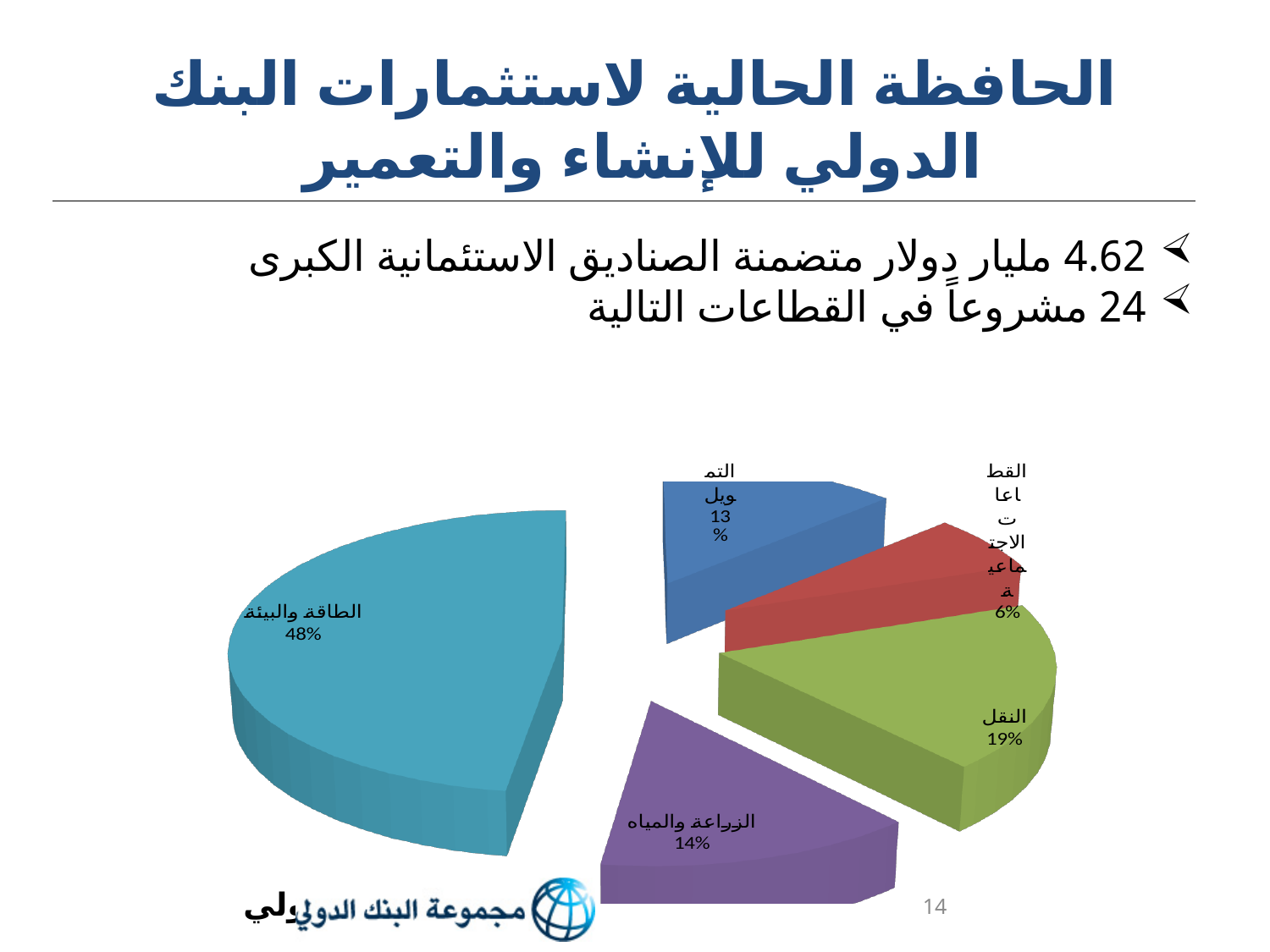
Which sector has the smallest slice of the pie? القطاعات الاجتماعية What kind of chart is shown on the slide? pie chart What is the difference in percentage points between الزراعة والمياه and التمويل? 1 What colour is the slice for الطاقة والبيئة? teal/light blue What share of the pie does النقل (transport) hold? 19% What is the difference in percentage points between الطاقة والبيئة and النقل? 29 How many slices does the pie chart have? 5 Which is larger, the share for النقل or the share for الزراعة والمياه? النقل What share of the pie does التمويل (finance) hold? 13% Which sector has the largest slice of the pie? الطاقة والبيئة What share of the pie does الطاقة والبيئة (energy and environment) hold? 48% What share of the pie does الزراعة والمياه (agriculture and water) hold? 14%